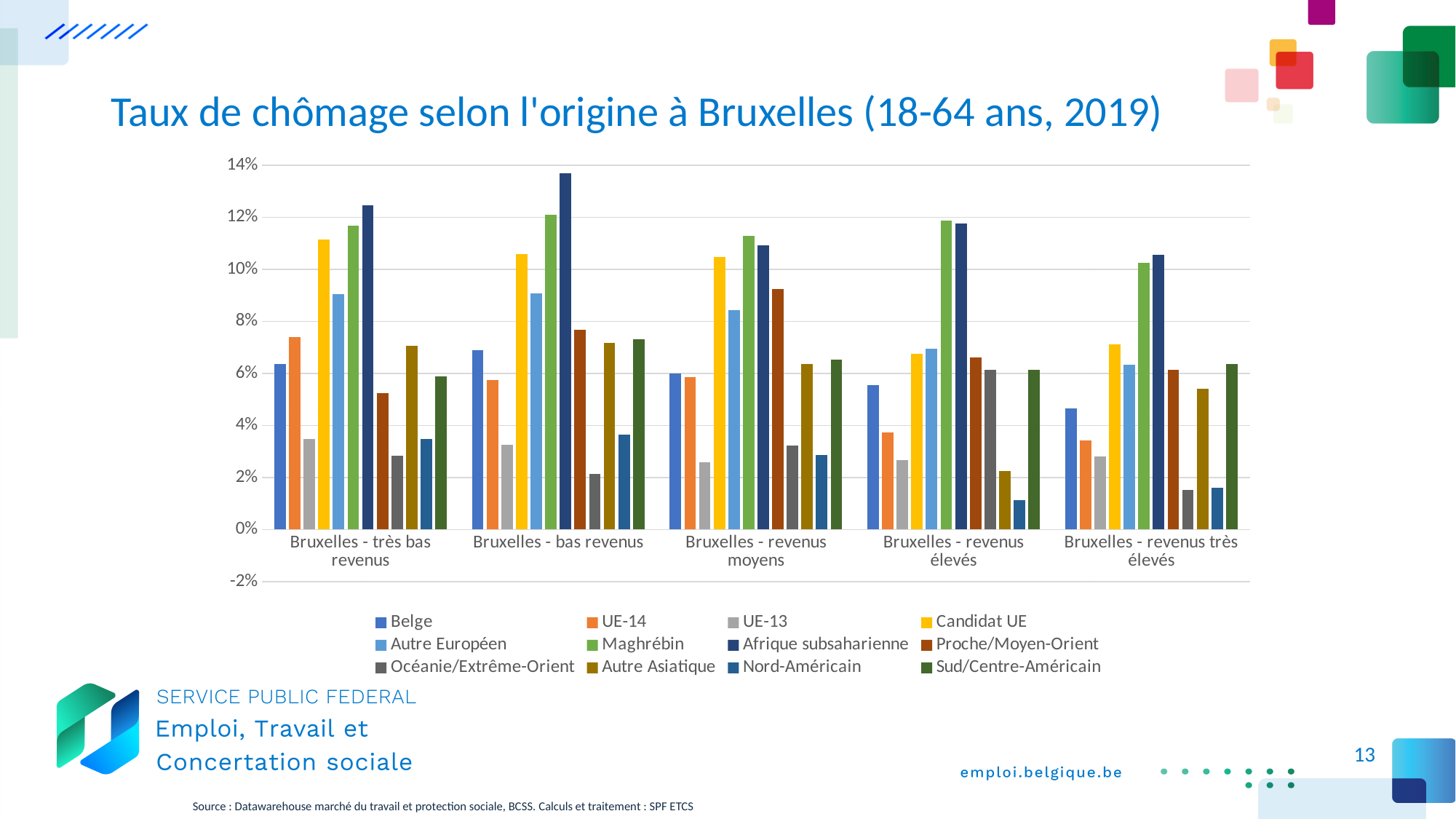
Is the value for Candidat UE in 'Bruxelles - très bas revenus' greater or less than 10%? greater What is the title of the chart? Taux de chômage selon l'origine à Bruxelles (18-64 ans, 2019) Which origin and income group has the tallest bar in the whole chart? Afrique subsaharienne, Bruxelles - bas revenus Is the Belge value in 'Bruxelles - revenus très élevés' higher or lower than in 'Bruxelles - très bas revenus'? lower In the 'Bruxelles - bas revenus' group, which origin has the highest unemployment rate? Afrique subsaharienne What kind of chart is shown on the slide? Bar chart Is the value for Océanie/Extrême-Orient in 'Bruxelles - bas revenus' greater or less than 4%? less How many income categories are shown on the x axis? 5 In 'Bruxelles - très bas revenus', which is larger: the value for UE-14 or for Belge? UE-14 How many series does the legend list? 12 Is the value for Belge in 'Bruxelles - revenus très élevés' greater or less than 6%? less In the 'Bruxelles - revenus élevés' group, which origin has the lowest unemployment rate? Nord-Américain